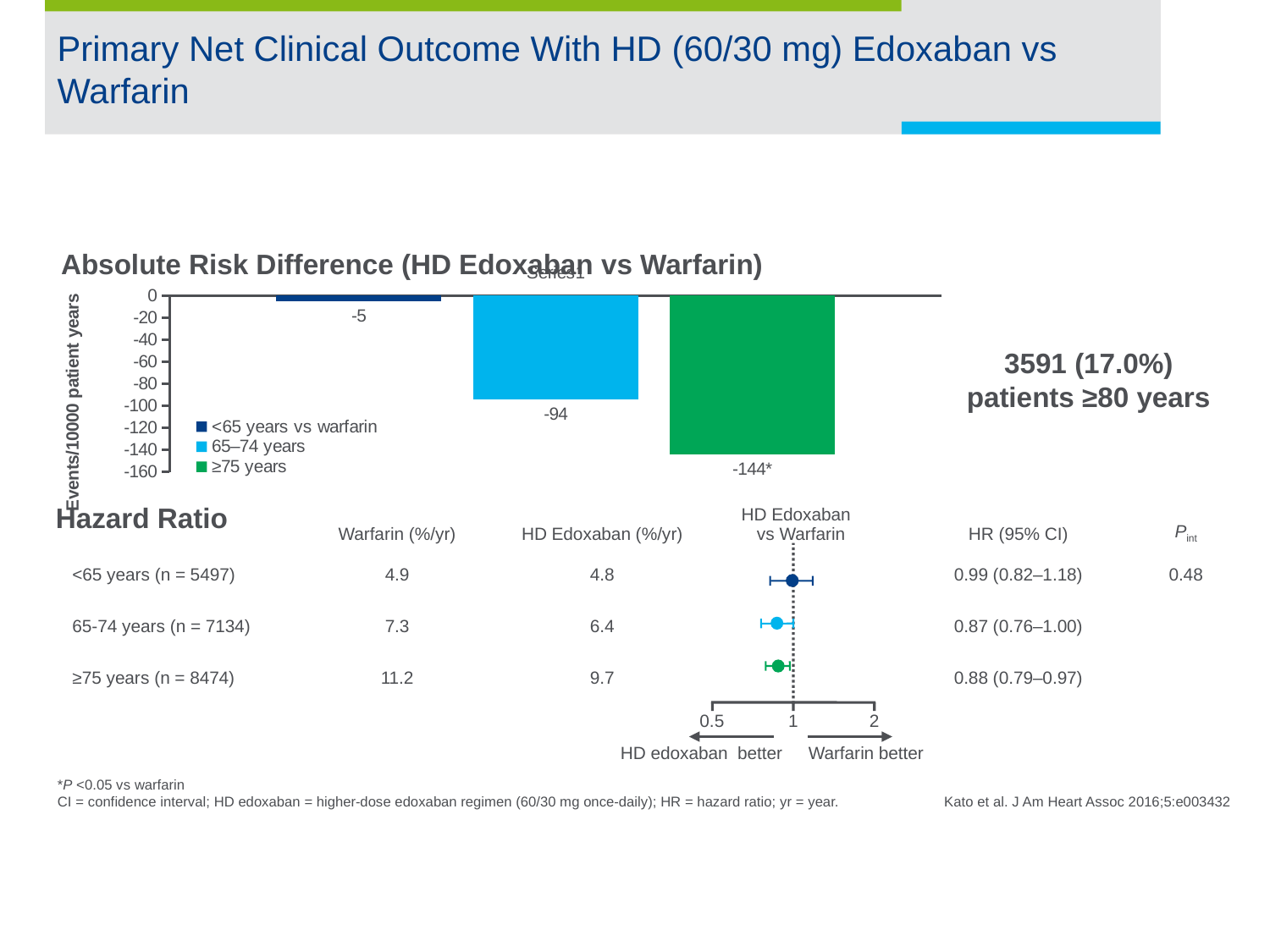
In the Absolute Risk Difference chart, what is the value for the ≥75 years bar? -144* How many bars are plotted in the Absolute Risk Difference chart? 3 In the Absolute Risk Difference chart, which age group has the lowest (most negative) value? ≥75 years In the Absolute Risk Difference chart, what is the value for the 65–74 years bar? -94 What type of chart is the Absolute Risk Difference chart? Bar chart How many entries does the legend of the Absolute Risk Difference chart list? 3 In the Absolute Risk Difference chart, is the 65–74 years bar more negative than the <65 years bar? Yes In the Absolute Risk Difference chart, what is the difference between the 65–74 years value and the <65 years value? 89 In the Absolute Risk Difference chart, what is the value for the <65 years vs warfarin bar? -5 In the Absolute Risk Difference chart, is the value for 65–74 years greater or less than -80? less In the Absolute Risk Difference chart, which age group has the value closest to zero? <65 years vs warfarin In the Absolute Risk Difference chart, what is the difference between the ≥75 years value and the 65–74 years value? 50